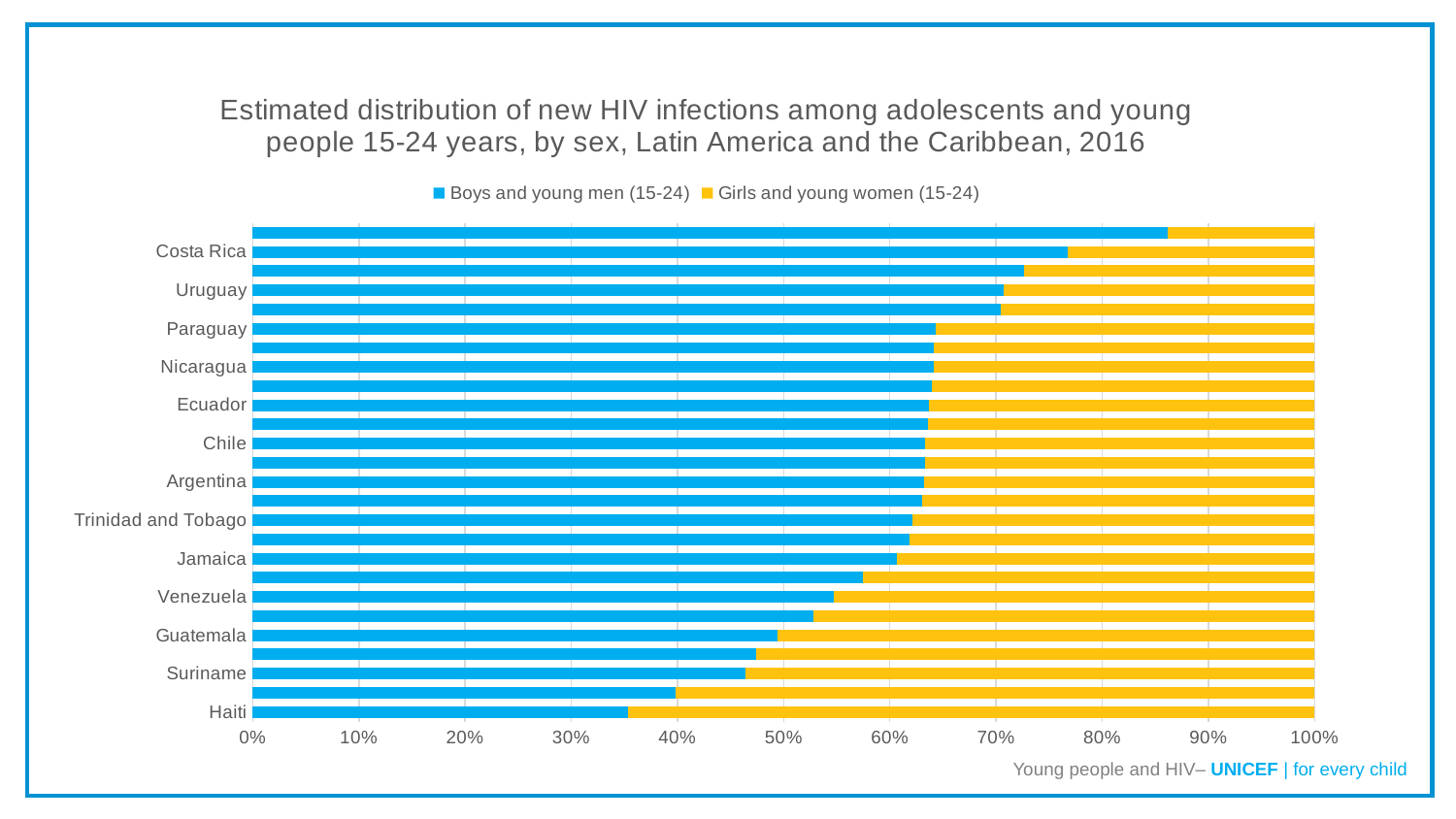
Is the share of Boys and young men (15-24) for Venezuela greater or less than 50%? greater Moving down the chart from Costa Rica to Haiti, does the share of Boys and young men (15-24) rise or fall? Fall Which colour represents Girls and young women (15-24) in the chart? Yellow Is the share of Boys and young men (15-24) for Haiti greater or less than 40%? less Which series is shown in blue? Boys and young men (15-24) Which country has the larger share of Boys and young men (15-24): Costa Rica or Haiti? Costa Rica Is the share of Boys and young men (15-24) for Paraguay greater or less than 60%? greater Which country has the larger share of Girls and young women (15-24): Haiti or Uruguay? Haiti What kind of chart is shown on the slide? Stacked bar chart How many series does the legend list? 2